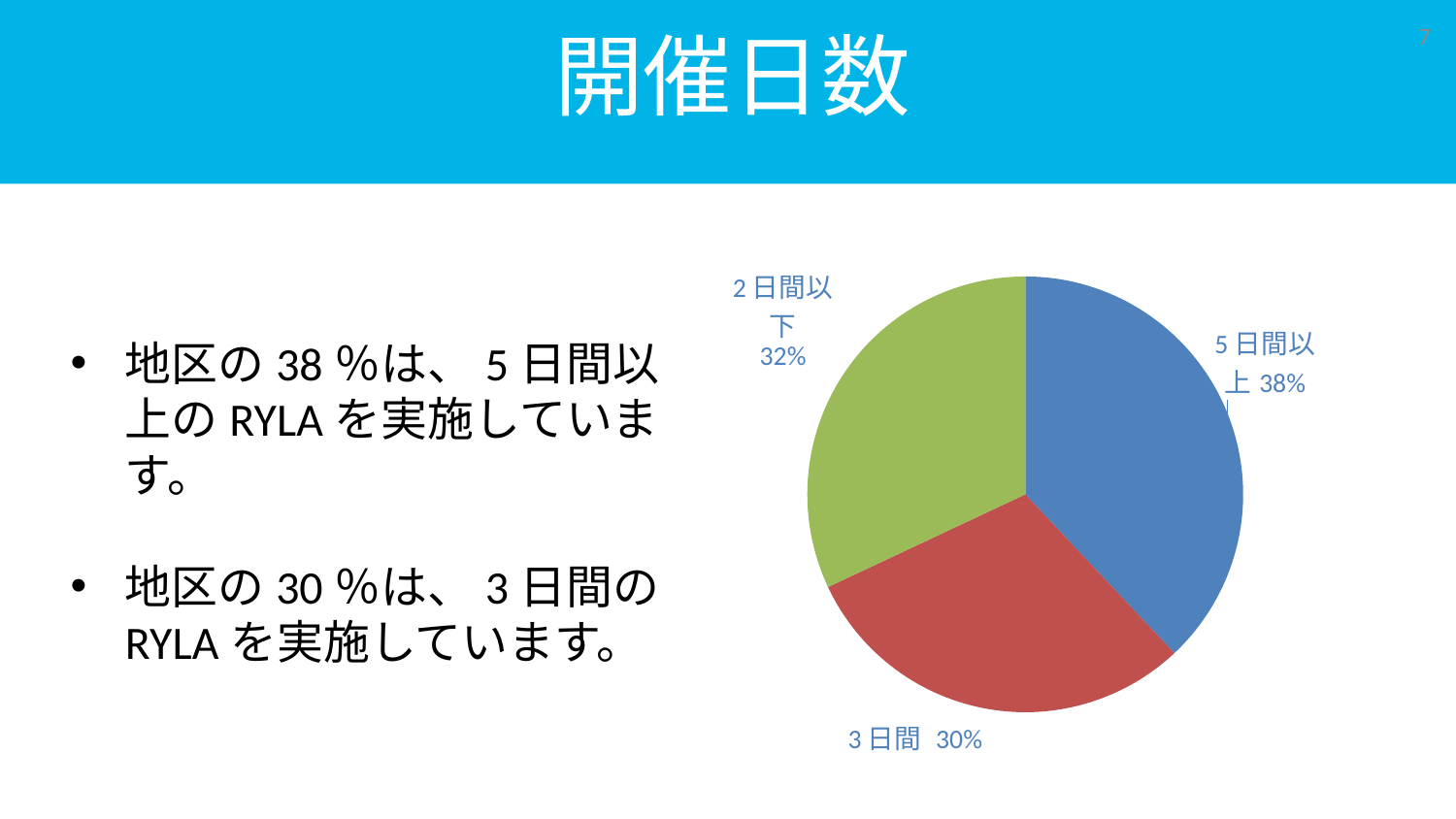
What kind of chart is shown on the slide? pie chart What share of the pie does 2 日間以下 represent? 32% What is the difference in percentage points between the 5 日間以上 slice and the 3 日間 slice? 8 What is the difference in percentage points between the 2 日間以下 slice and the 3 日間 slice? 2 Which is larger, the 2 日間以下 slice or the 3 日間 slice? 2 日間以下 What colour is the 3 日間 slice of the pie? red Which category has the largest slice of the pie? 5 日間以上 Which category has the smallest slice of the pie? 3 日間 What share of the pie does 3 日間 represent? 30% What share of the pie does 5 日間以上 represent? 38% How many slices does the pie chart have? 3 What is the title of the slide containing the pie chart? 開催日数